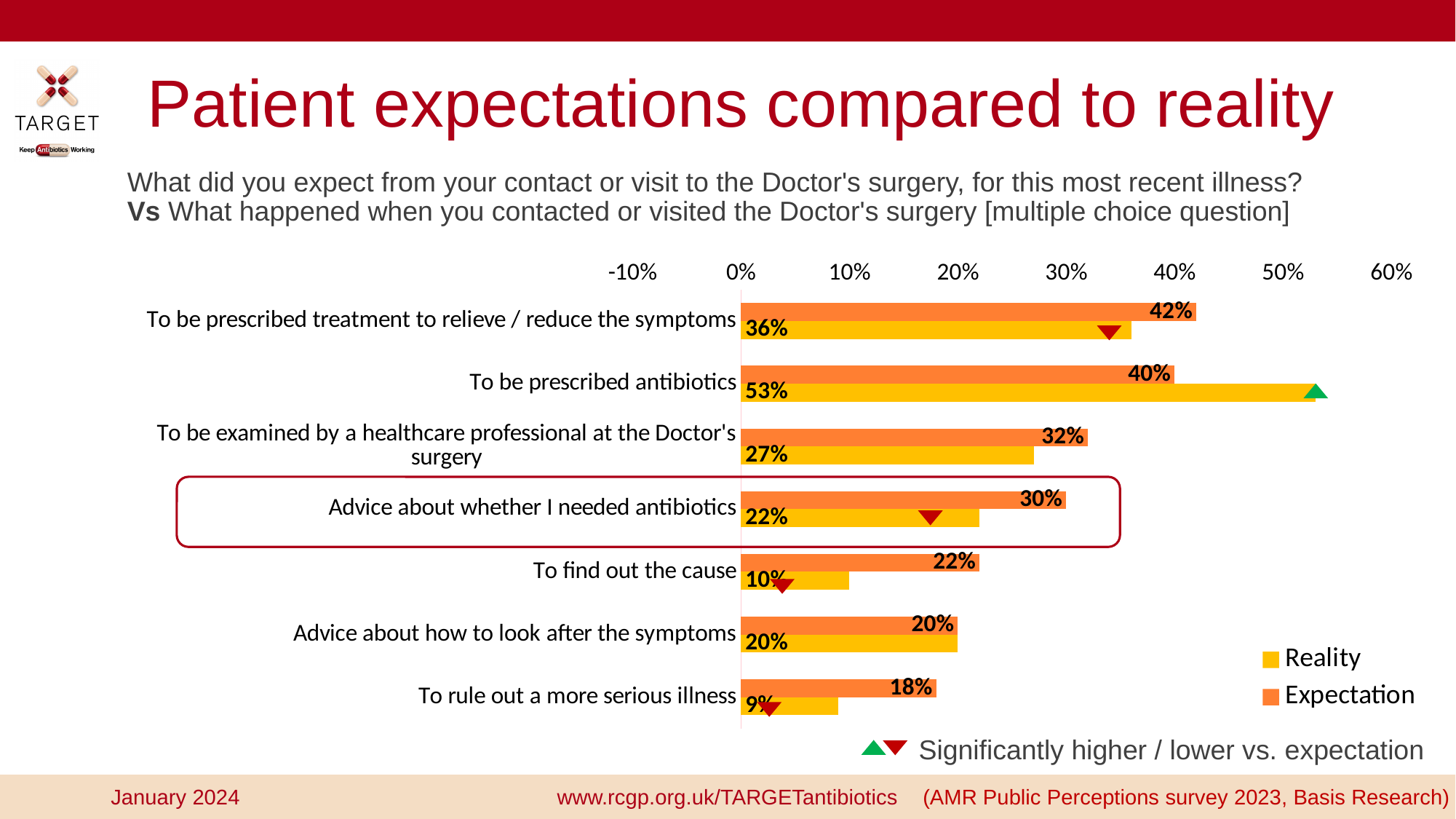
How many categories are shown in the chart? 7 How many series does the legend list? 2 For 'To be prescribed antibiotics', which is larger: the Reality value or the Expectation value? Reality What is the Expectation value for 'To rule out a more serious illness'? 18% What is the Expectation value for 'To be prescribed antibiotics'? 40% Which colour represents the Reality series in the chart? Yellow What is the difference between the Expectation and Reality values for 'To find out the cause'? 12% What is the Reality value for 'Advice about whether I needed antibiotics'? 22% What kind of chart is shown on the slide? Bar chart What is the Reality value for 'To be prescribed antibiotics'? 53% Which category has the lowest Reality value? To rule out a more serious illness Which category has the highest Expectation value? To be prescribed treatment to relieve / reduce the symptoms